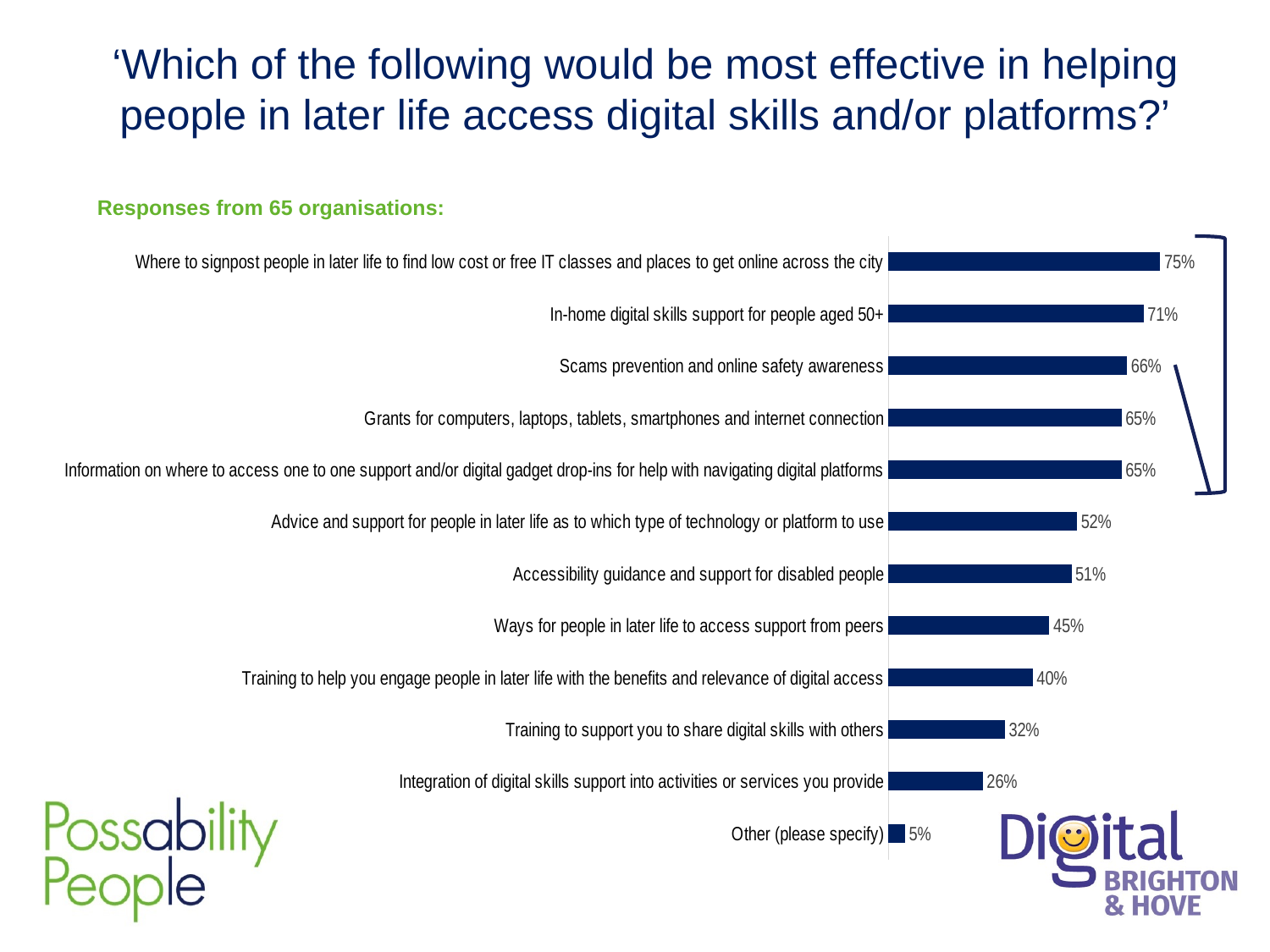
Which option has the highest percentage? Where to signpost people in later life to find low cost or free IT classes and places to get online across the city What percentage is shown for 'Accessibility guidance and support for disabled people'? 51% Which is larger: 'Integration of digital skills support into activities or services you provide' or 'Training to help you engage people in later life with the benefits and relevance of digital access'? Training to help you engage people in later life with the benefits and relevance of digital access How many organisations responded, according to the subtitle? 65 What is the value for 'Training to support you to share digital skills with others'? 32% What kind of chart is shown on the slide? Bar chart What is the difference between the highest value and the value for 'Other (please specify)'? 70% Which option has the lowest percentage? Other (please specify) What percentage of organisations selected 'Scams prevention and online safety awareness'? 66% How many options are shown in the chart? 12 What is the difference between 'In-home digital skills support for people aged 50+' and 'Ways for people in later life to access support from peers'? 26% Which two options share the same value of 65%? Grants for computers, laptops, tablets, smartphones and internet connection; Information on where to access one to one support and/or digital gadget drop-ins for help with navigating digital platforms